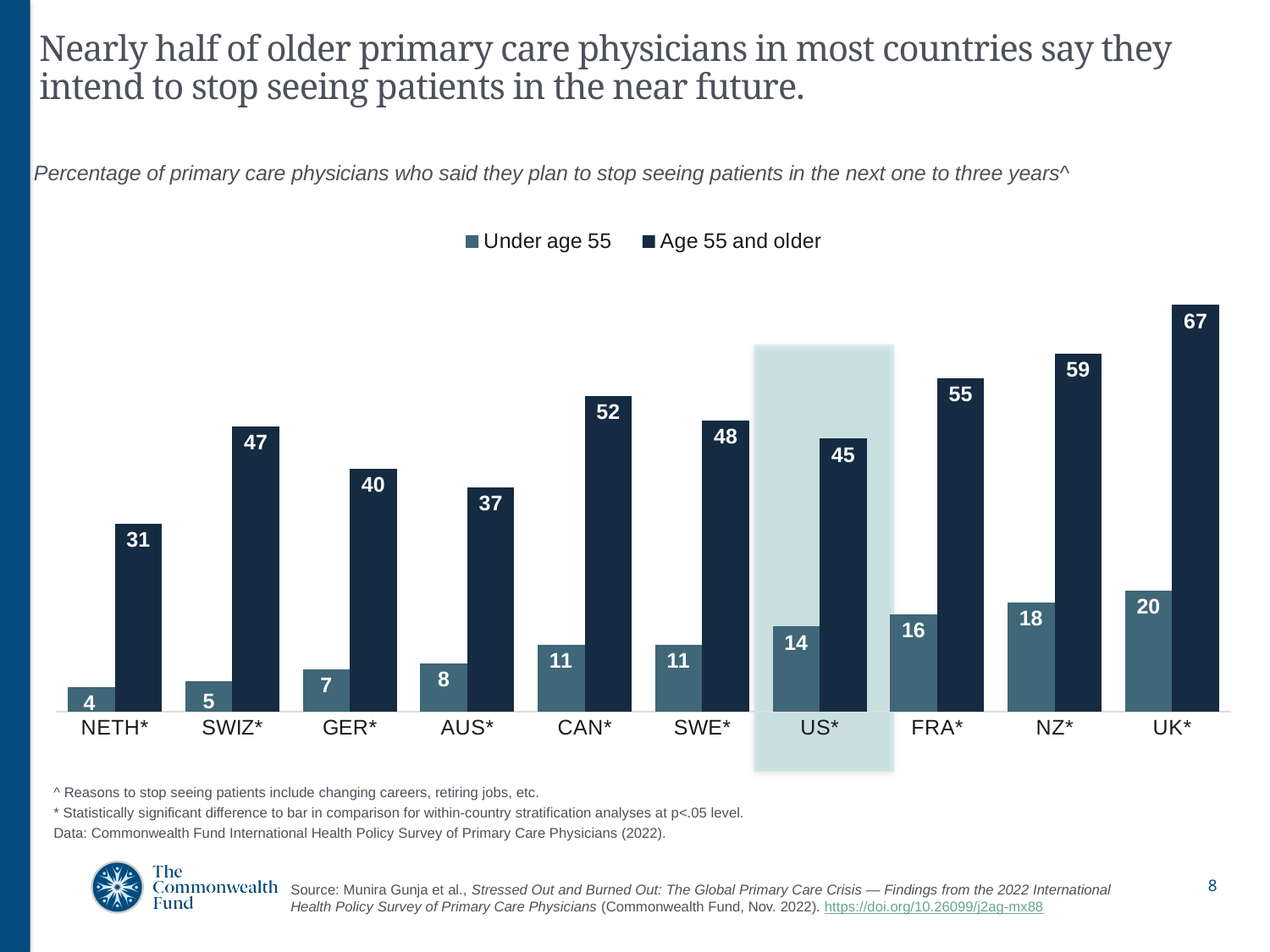
Which is larger: the Age 55 and older value for FRA* or for SWE*? FRA* How many countries are shown on the x axis? 10 What is the difference between the Age 55 and older and Under age 55 values for CAN*? 41 Do the Age 55 and older values generally rise or fall from NETH* to UK* along the x axis? Rise Which country's bars are highlighted with a shaded background? US* What kind of chart is shown on the slide? Bar chart What is the value for Age 55 and older in the US*? 45 Which country has the highest value for Age 55 and older? UK* What is the value for Under age 55 in GER*? 7 What is the value for Under age 55 in NZ*? 18 How many series does the legend list? 2 Which country has the lowest value for Under age 55? NETH*